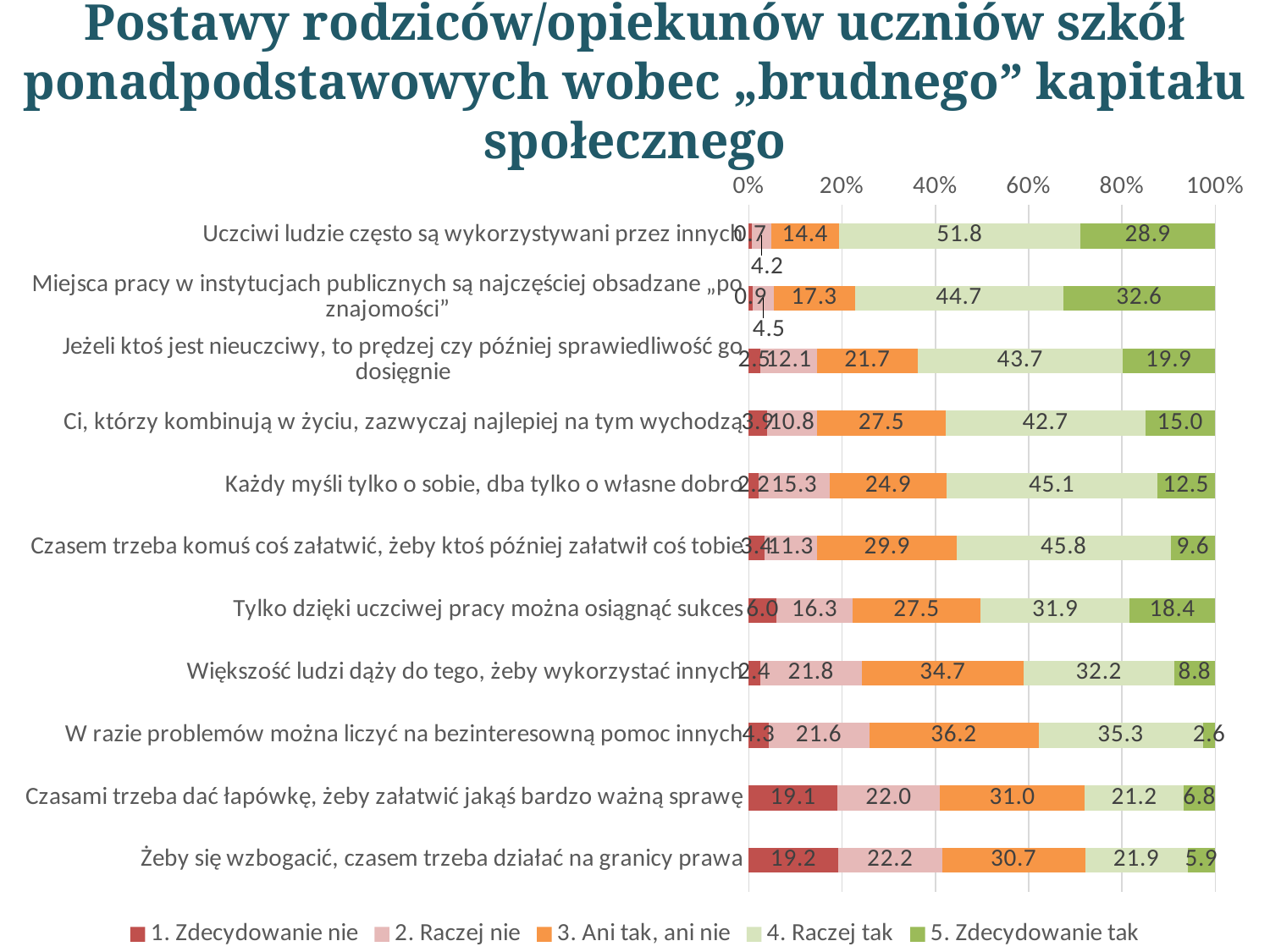
What is the value of "2. Raczej nie" for "Czasami trzeba dać łapówkę, żeby załatwić jakąś bardzo ważną sprawę"? 22.0 What is the difference between the "4. Raczej tak" values for "Uczciwi ludzie często są wykorzystywani przez innych" and "Miejsca pracy w instytucjach publicznych są najczęściej obsadzane „po znajomości”"? 7.1 How many statements (categories) are plotted in the chart? 11 What is the value of "4. Raczej tak" for "Uczciwi ludzie często są wykorzystywani przez innych"? 51.8 Which statement has the highest value for "5. Zdecydowanie tak"? Miejsca pracy w instytucjach publicznych są najczęściej obsadzane „po znajomości” What is the first entry in the chart's legend? 1. Zdecydowanie nie What is the value of "1. Zdecydowanie nie" for "Żeby się wzbogacić, czasem trzeba działać na granicy prawa"? 19.2 Which statement has the lowest value for "5. Zdecydowanie tak"? W razie problemów można liczyć na bezinteresowną pomoc innych How many series does the legend list? 5 What kind of chart is shown on the slide? bar chart What is the value of "5. Zdecydowanie tak" for "Miejsca pracy w instytucjach publicznych są najczęściej obsadzane „po znajomości”"? 32.6 Which has the larger value for "3. Ani tak, ani nie": "W razie problemów można liczyć na bezinteresowną pomoc innych" or "Większość ludzi dąży do tego, żeby wykorzystać innych"? W razie problemów można liczyć na bezinteresowną pomoc innych